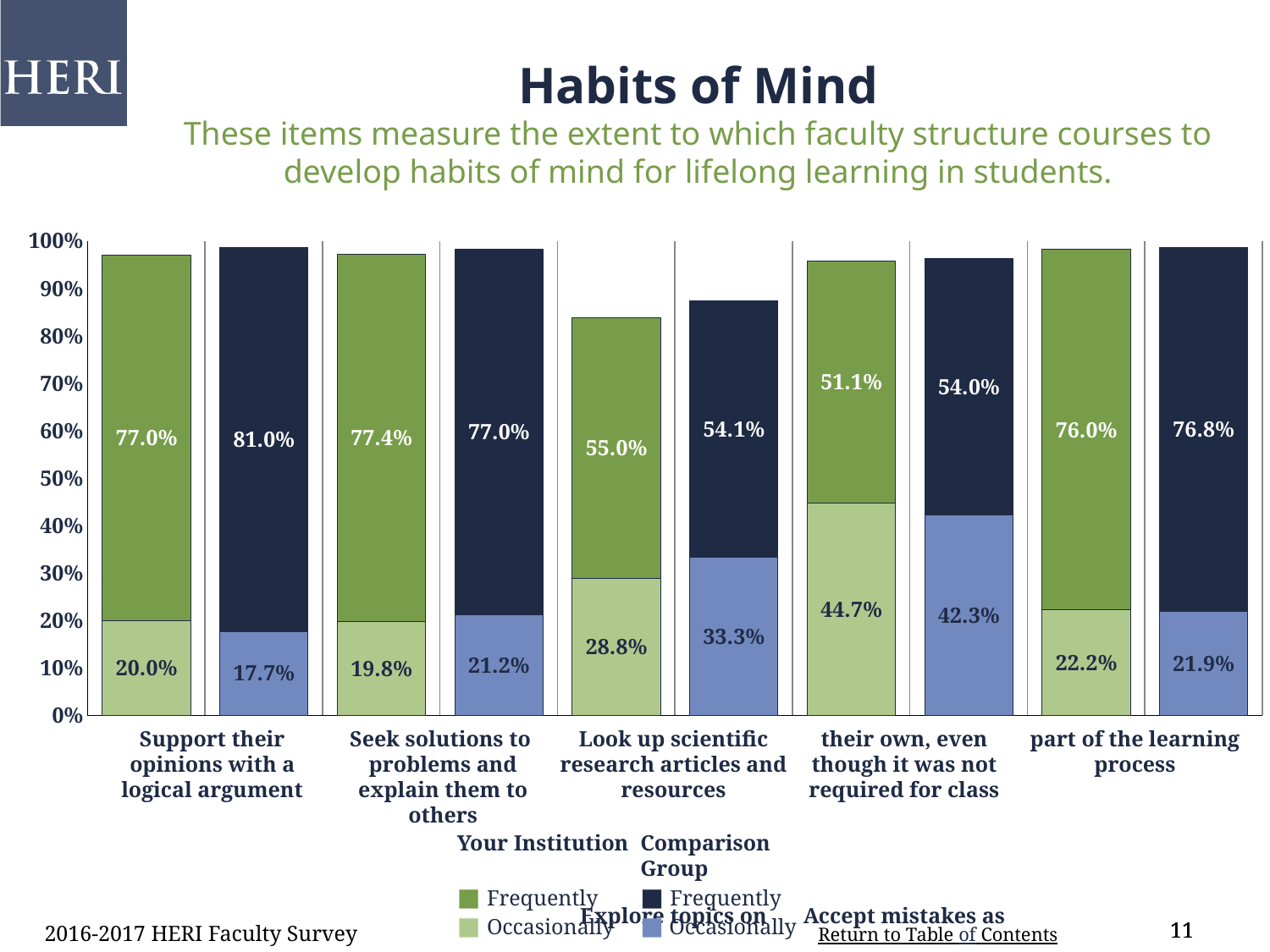
For 'Look up scientific research articles and resources', which has the larger 'Occasionally' value: Your Institution or the Comparison Group? Comparison Group How much higher is the Comparison Group 'Frequently' value than the Your Institution 'Frequently' value for 'Support their opinions with a logical argument'? 4.0 percentage points What is the 'Occasionally' value for the Comparison Group on 'Look up scientific research articles and resources'? 33.3% How many entries does the chart legend list? 4 What is the Comparison Group 'Frequently' value for the category ending 'part of the learning process'? 76.8% Which category has the lowest Your Institution 'Frequently' value? their own, even though it was not required for class (51.1%) What is the total of the Your Institution stacked bar for 'Support their opinions with a logical argument'? 97.0% What kind of chart is shown on the slide? Stacked bar chart Which category has the highest Comparison Group 'Frequently' value? Support their opinions with a logical argument What is the total of the Comparison Group stacked bar for 'Seek solutions to problems and explain them to others'? 98.2% How many categories are shown along the x axis of the chart? 5 What is the 'Frequently' value for Your Institution on 'Support their opinions with a logical argument'? 77.0%